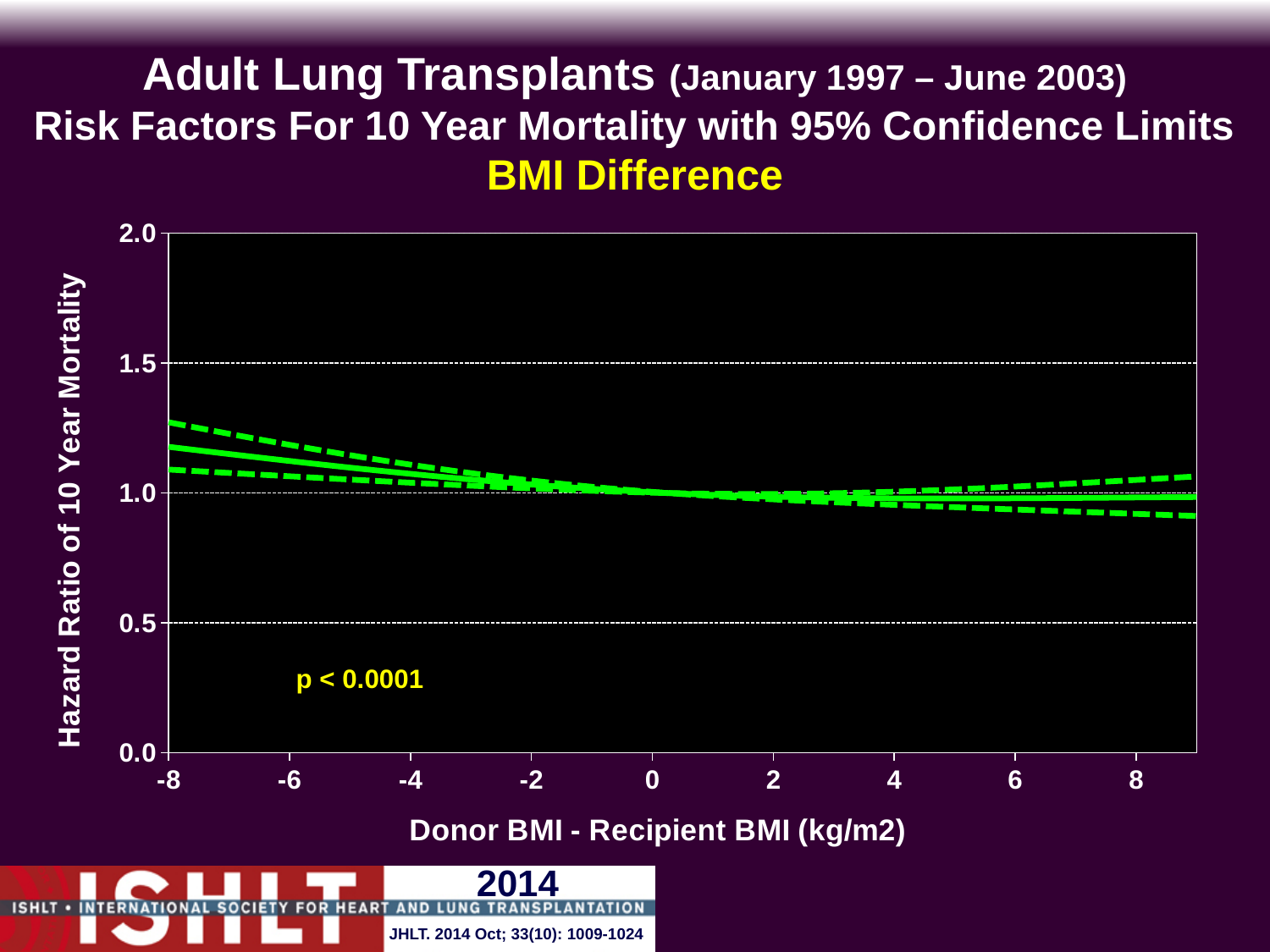
Is the hazard ratio (solid line) at a BMI difference of -8 greater or less than 1.0? greater Does the solid hazard ratio line rise or fall as Donor BMI - Recipient BMI increases from -8 to 8? fall Is the lower confidence limit (lower dashed line) at a BMI difference of 8 greater or less than 0.5? greater Is the hazard ratio (solid line) higher at a BMI difference of -8 or at a BMI difference of 8? -8 What kind of chart is shown on the slide? line chart What p-value is printed on the chart? p < 0.0001 What is the title of the chart (the yellow subtitle)? BMI Difference Is the upper confidence limit (upper dashed line) at a BMI difference of -8 greater or less than 1.5? less How many lines are plotted on the chart? 3 What is the label of the x axis? Donor BMI - Recipient BMI (kg/m2)